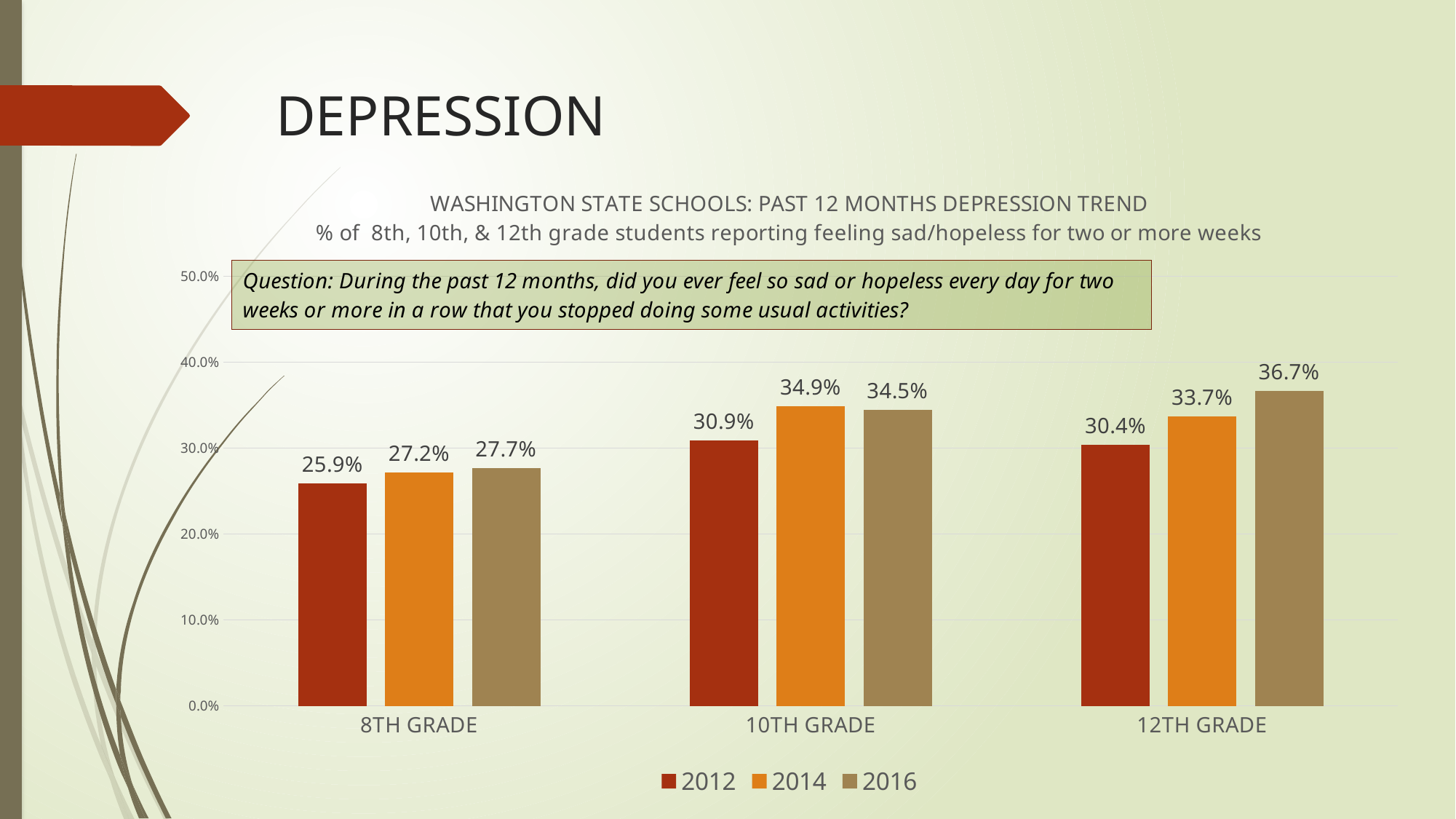
Do the 8th grade values rise or fall from 2012 to 2016? rise Is the value for 8th grade in 2016 greater or less than 30.0%? less What is the value for 12th grade in 2016? 36.7% What is the difference between the 12th grade values for 2016 and 2012? 6.3% What is the value for 10th grade in 2014? 34.9% Which is larger for 10th grade: the 2014 value or the 2016 value? 2014 What kind of chart is shown on the slide? bar chart Which grade has the lowest value in 2012? 8th grade What percentage of 8th grade students reported feeling sad/hopeless in 2012? 25.9% How many series does the legend list? 3 Which grade has the highest value in 2016? 12th grade How many grade categories are shown on the x axis? 3